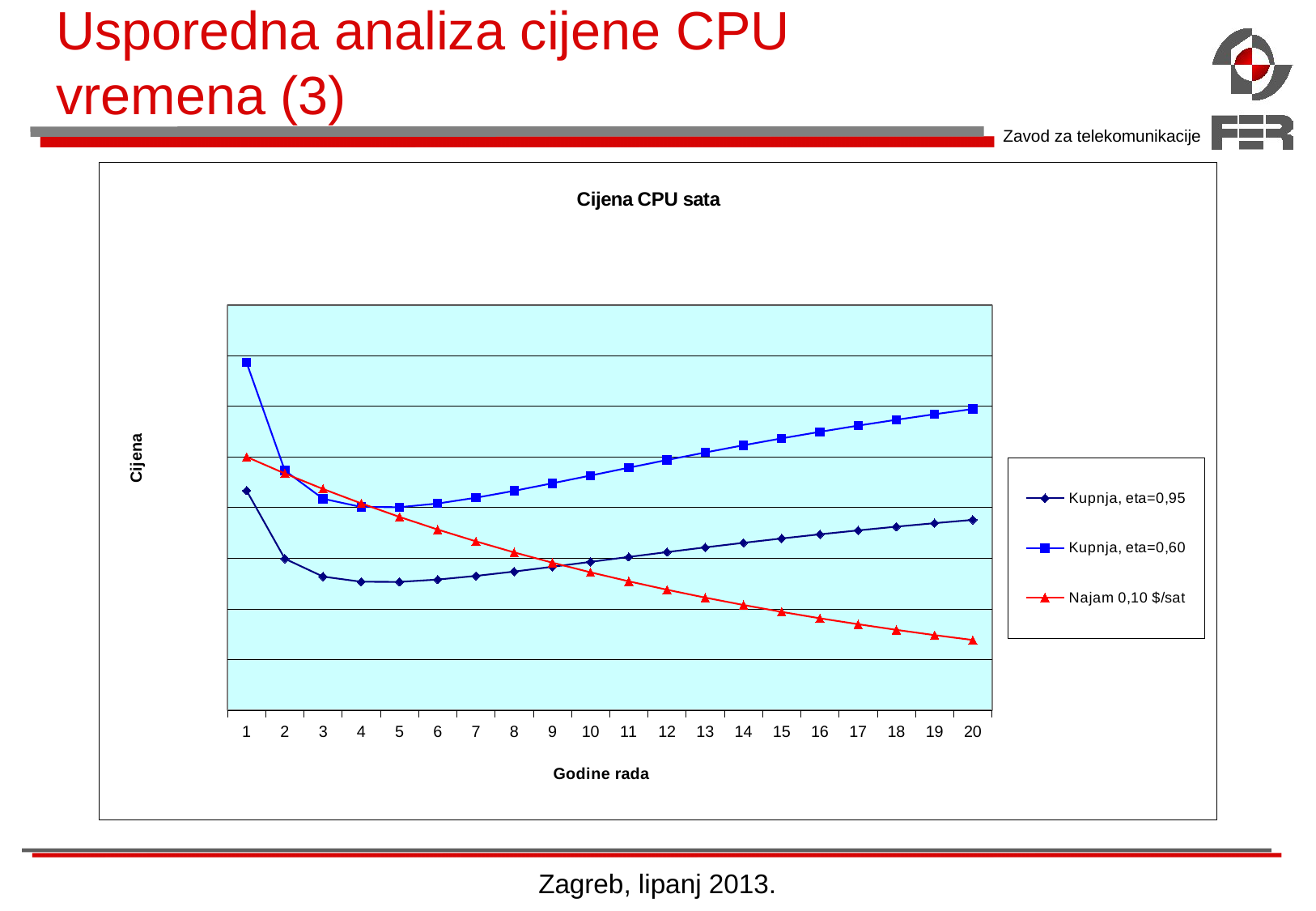
In which year is the value of the Kupnja, eta=0,60 series highest? 1 How many series does the legend list? 3 At year 20, which series has the larger value: Kupnja, eta=0,60 or Kupnja, eta=0,95? Kupnja, eta=0,60 At year 15, which series has the larger value: Najam 0,10 $/sat or Kupnja, eta=0,95? Kupnja, eta=0,95 In which year is the value of the Najam 0,10 $/sat series highest? 1 What kind of chart is shown on the slide? line chart In which year is the value of the Najam 0,10 $/sat series lowest? 20 Does the Najam 0,10 $/sat series rise or fall as the years of work increase? fall Does the Kupnja, eta=0,60 series rise or fall between year 5 and year 20? rise What is the title of the chart? Cijena CPU sata What is the label of the x axis? Godine rada How many years (categories) are shown on the x axis? 20